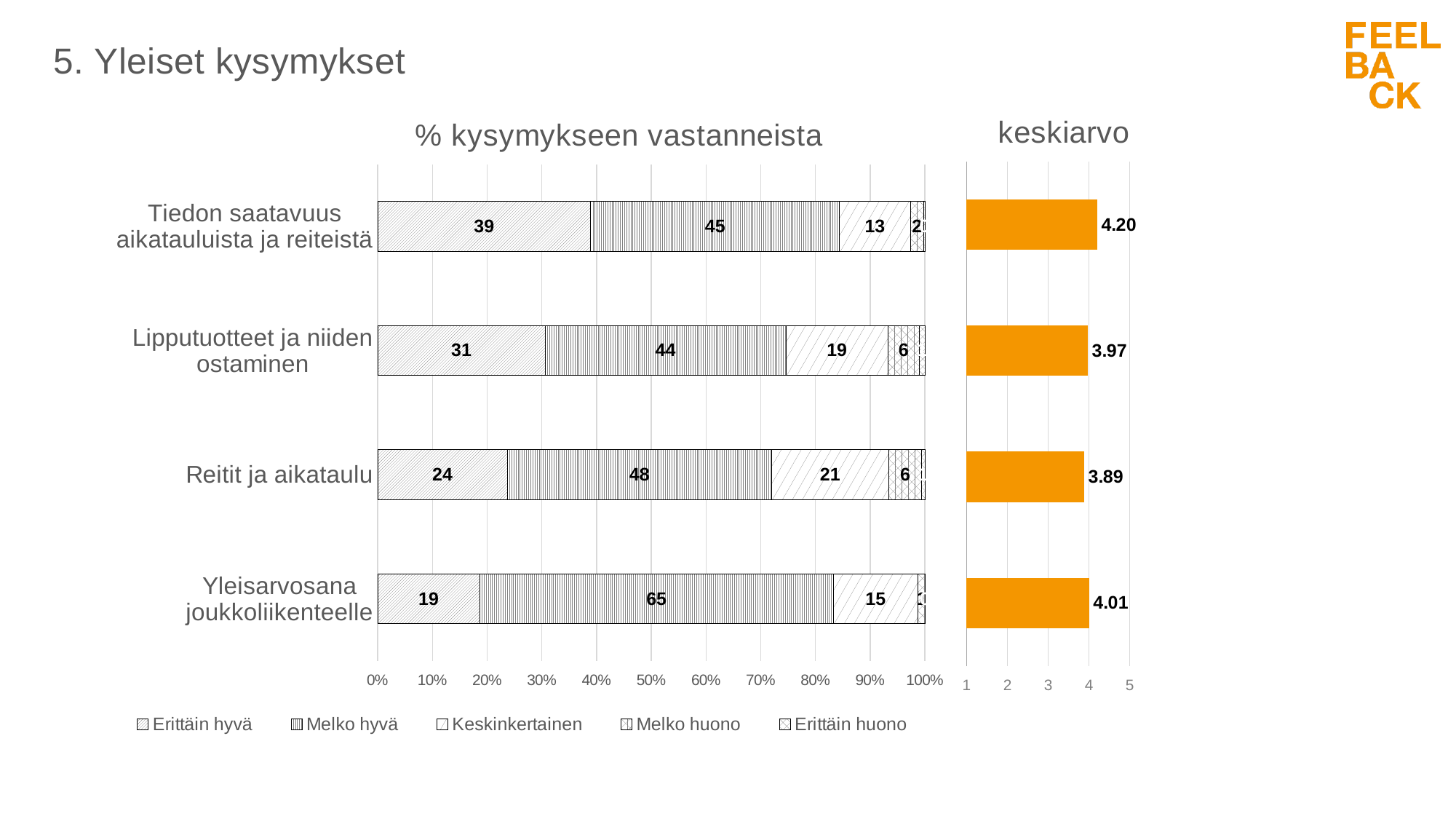
In the keskiarvo chart, which category has the lowest value? Reitit ja aikataulu In the keskiarvo chart, what is the difference between the values for Tiedon saatavuus aikatauluista ja reiteistä and Reitit ja aikataulu? 0.31 What kind of chart is the keskiarvo chart? Bar chart In the % kysymykseen vastanneista chart, what is the Melko hyvä value for Reitit ja aikataulu? 48 In the % kysymykseen vastanneista chart, what is the Erittäin hyvä value for Yleisarvosana joukkoliikenteelle? 19 In the % kysymykseen vastanneista chart, which category has the highest Melko hyvä value? Yleisarvosana joukkoliikenteelle In the % kysymykseen vastanneista chart, which has the larger Keskinkertainen value: Lipputuotteet ja niiden ostaminen or Tiedon saatavuus aikatauluista ja reiteistä? Lipputuotteet ja niiden ostaminen How many categories are shown in the keskiarvo chart? 4 In the % kysymykseen vastanneista chart, what is the difference between the Erittäin hyvä values for Tiedon saatavuus aikatauluista ja reiteistä and Yleisarvosana joukkoliikenteelle? 20 In the keskiarvo chart, which category has the highest value? Tiedon saatavuus aikatauluista ja reiteistä In the keskiarvo chart, what is the value for Tiedon saatavuus aikatauluista ja reiteistä? 4.20 How many series does the legend of the % kysymykseen vastanneista chart list? 5